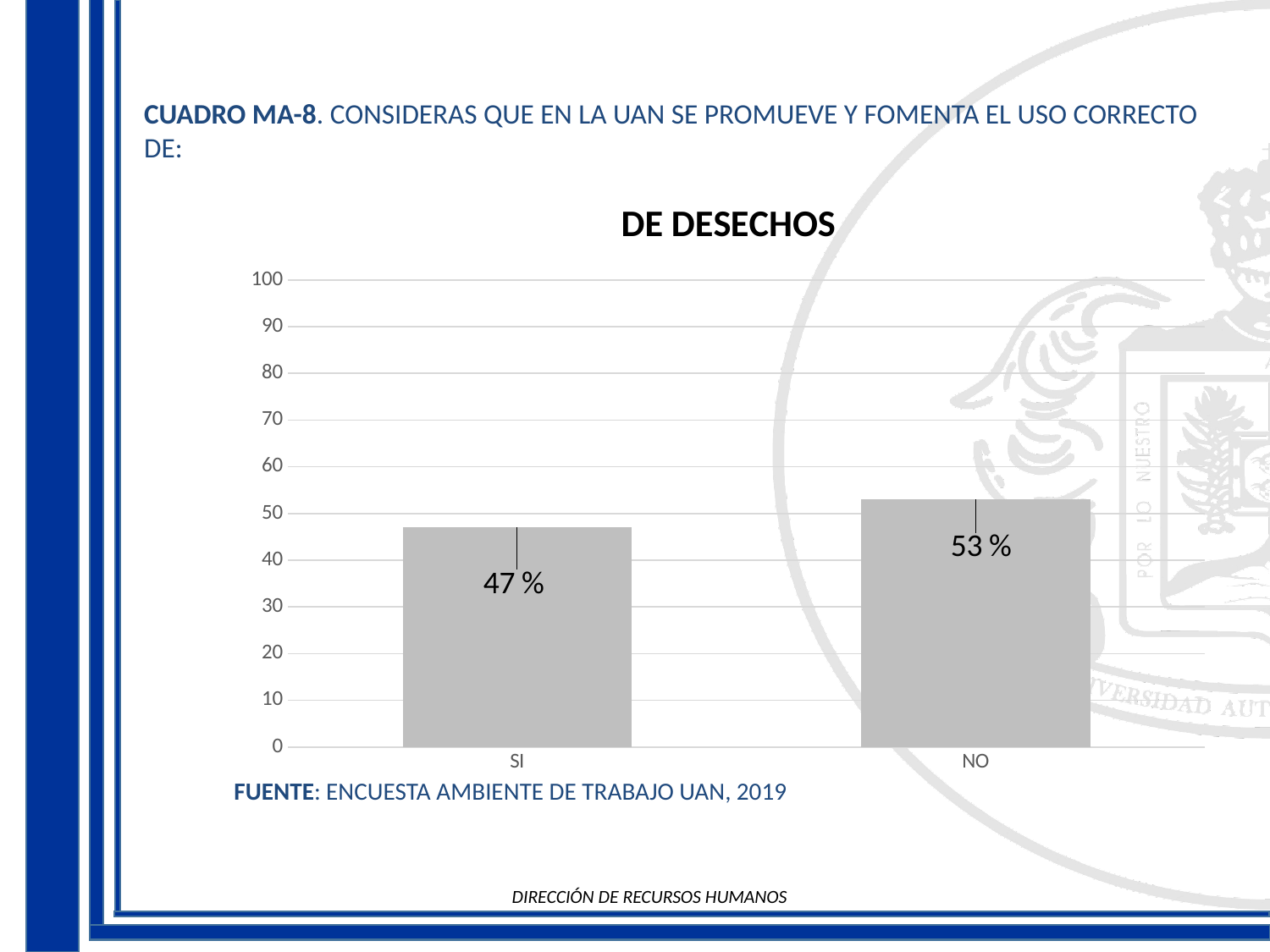
What kind of chart is shown on the slide? bar chart What is the maximum value shown on the y axis? 100 What is the value for NO? 53 % Is the value for NO greater or less than 50? greater Is the value for SI greater or less than 50? less What is the difference between the values for NO and SI? 6 % Which category has the lowest value? SI Which category has the highest value? NO Which is larger, the value for SI or the value for NO? NO How many categories are shown on the x axis? 2 What is the title of the chart? DE DESECHOS What is the value for SI? 47 %